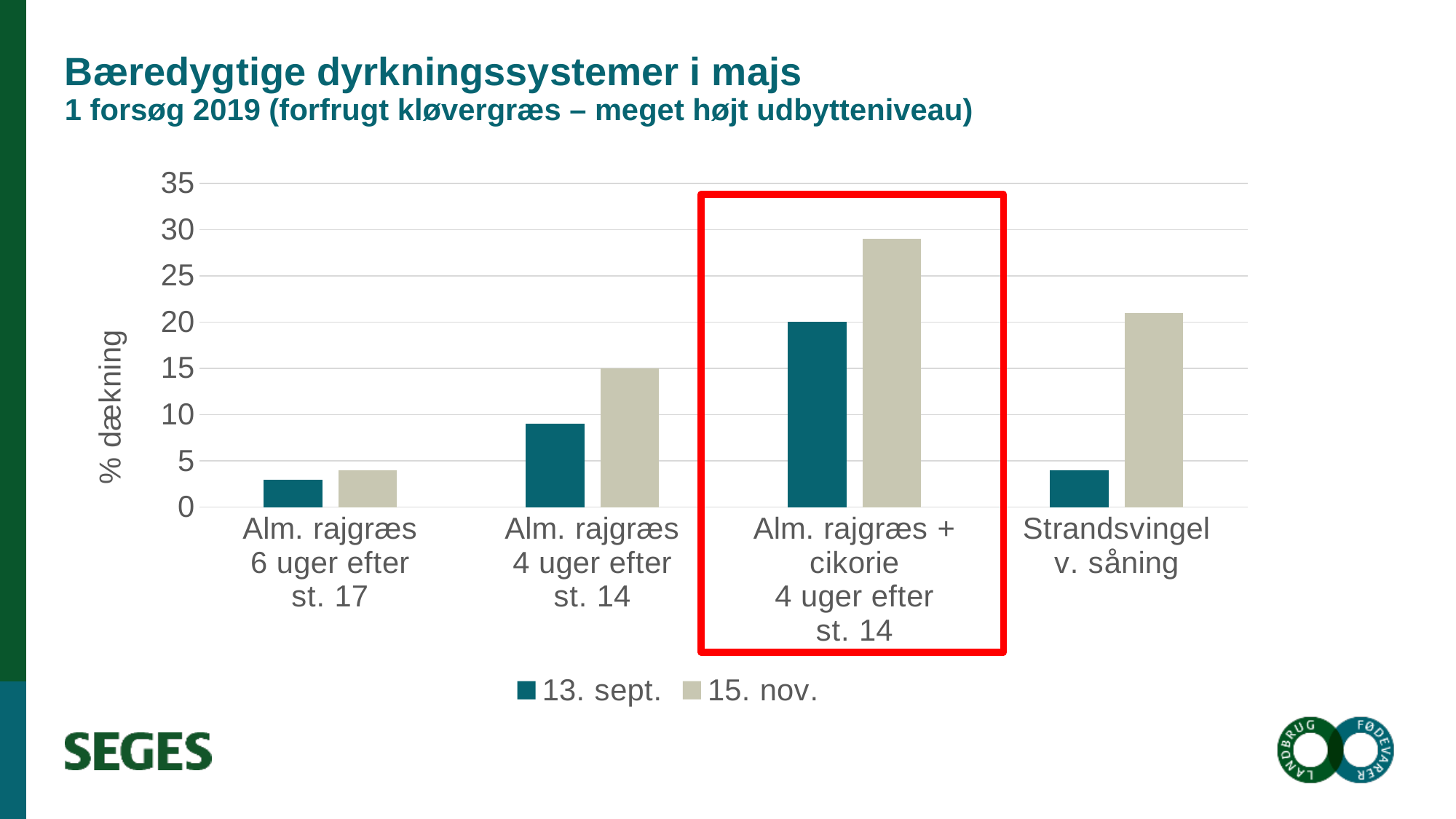
What kind of chart is shown on the slide? bar chart Is the value for 13. sept. for Alm. rajgræs 4 uger efter st. 14 greater or less than 10? less Which category has the lowest value for 13. sept.? Alm. rajgræs 6 uger efter st. 17 Which is larger for Alm. rajgræs 4 uger efter st. 14: the 13. sept. value or the 15. nov. value? 15. nov. Is the value for 13. sept. for Strandsvingel v. såning greater or less than 5? less What is the label of the y axis? % dækning Is the value for 15. nov. for Strandsvingel v. såning greater or less than 20? greater Which category has the highest value for 15. nov.? Alm. rajgræs + cikorie 4 uger efter st. 14 How many series does the legend list? 2 How many categories are shown on the x axis? 4 Which is larger for 13. sept.: Alm. rajgræs + cikorie or Strandsvingel v. såning? Alm. rajgræs + cikorie